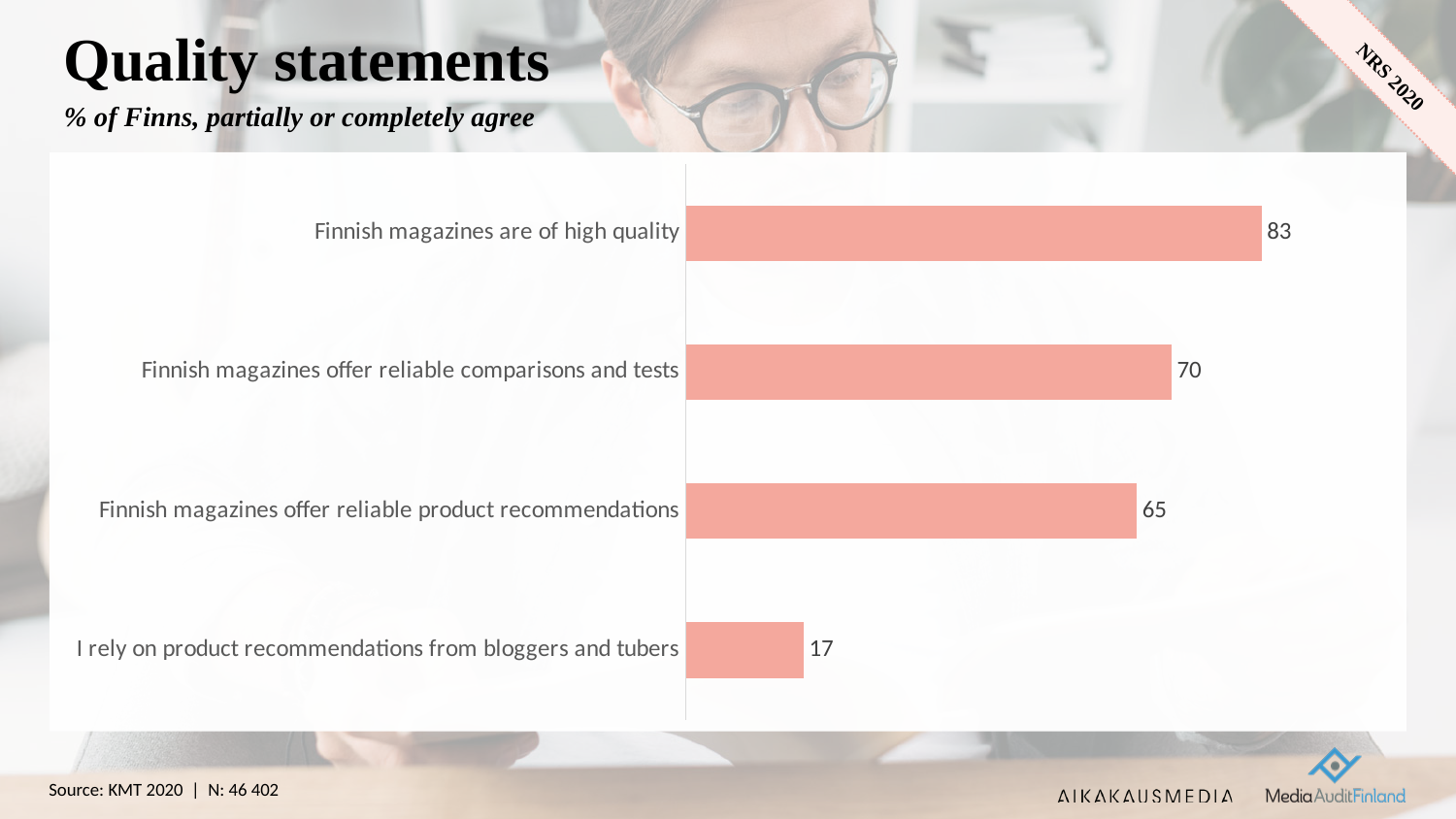
Which statement has the lowest level of agreement? I rely on product recommendations from bloggers and tubers How many statements are shown in the chart? 4 What is the value for 'Finnish magazines offer reliable comparisons and tests'? 70 What is the difference between the values for 'Finnish magazines offer reliable comparisons and tests' and 'Finnish magazines offer reliable product recommendations'? 5 What is the difference between the values for 'Finnish magazines are of high quality' and 'I rely on product recommendations from bloggers and tubers'? 66 Which is larger: the value for 'Finnish magazines offer reliable comparisons and tests' or for 'Finnish magazines offer reliable product recommendations'? Finnish magazines offer reliable comparisons and tests What is the title of the slide? Quality statements What type of chart is shown on the slide? Bar chart What is the value for 'Finnish magazines offer reliable product recommendations'? 65 What percentage of Finns agree that Finnish magazines are of high quality? 83 Which statement has the highest level of agreement? Finnish magazines are of high quality What is the value for 'I rely on product recommendations from bloggers and tubers'? 17